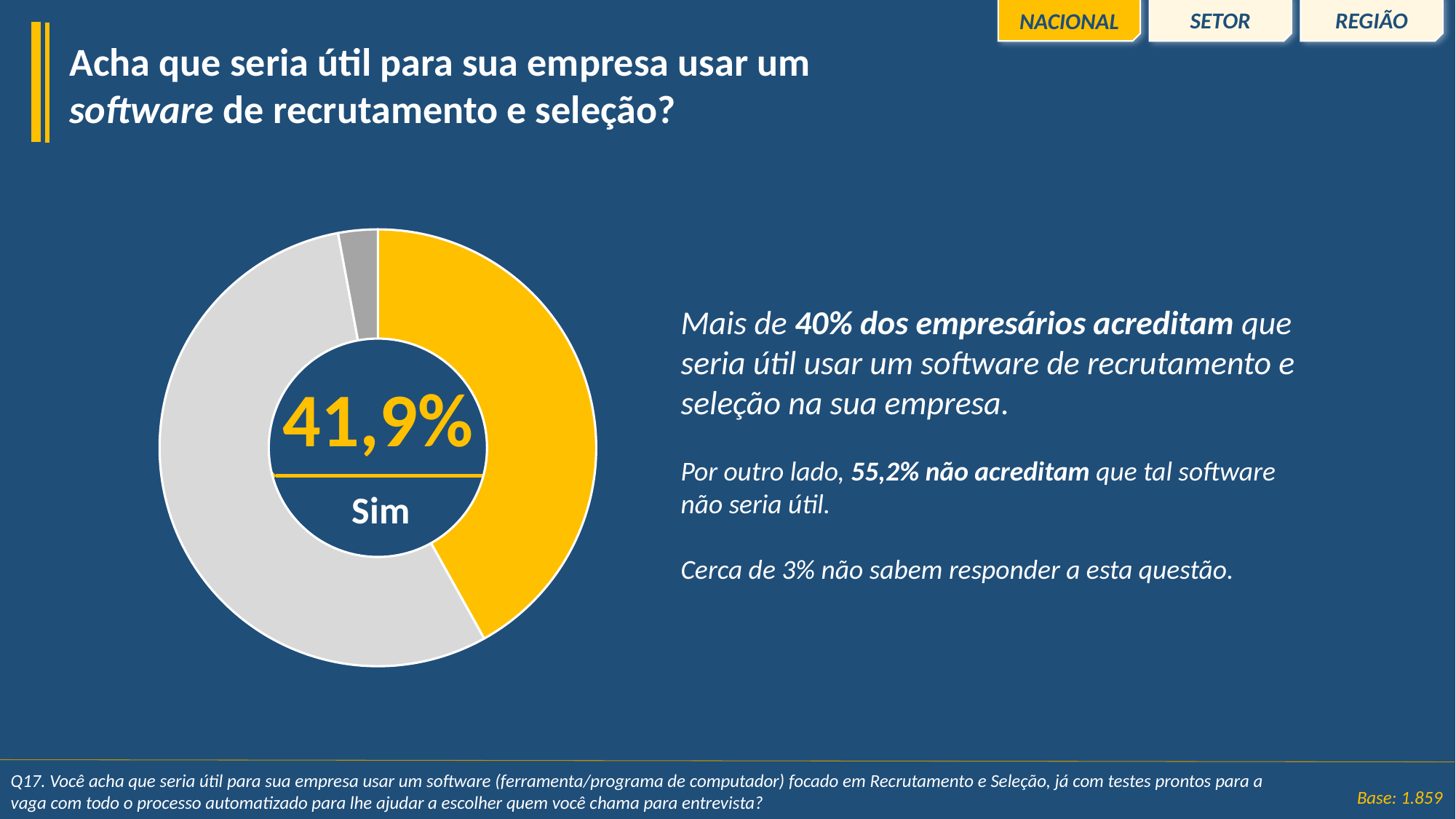
Which is larger in the donut chart: the yellow slice or the dark gray slice? The yellow slice Is the share of the yellow "Sim" slice greater or less than 50%? less What is the base (number of respondents) shown on the slide? 1.859 Which colour slice of the donut chart is the largest? Light gray How many slices does the donut chart have? 3 What kind of chart is shown on the slide? Pie chart (donut) Which colour slice of the donut chart is the smallest? Dark gray What label appears in the centre of the donut chart below the percentage? Sim What colour is the "Sim" slice of the donut chart? Yellow Which is larger in the donut chart: the yellow slice or the light gray slice? The light gray slice What percentage is shown for "Sim" in the centre of the donut chart? 41,9% According to the text beside the chart, what percentage of respondents do not believe the software would be useful? 55,2%